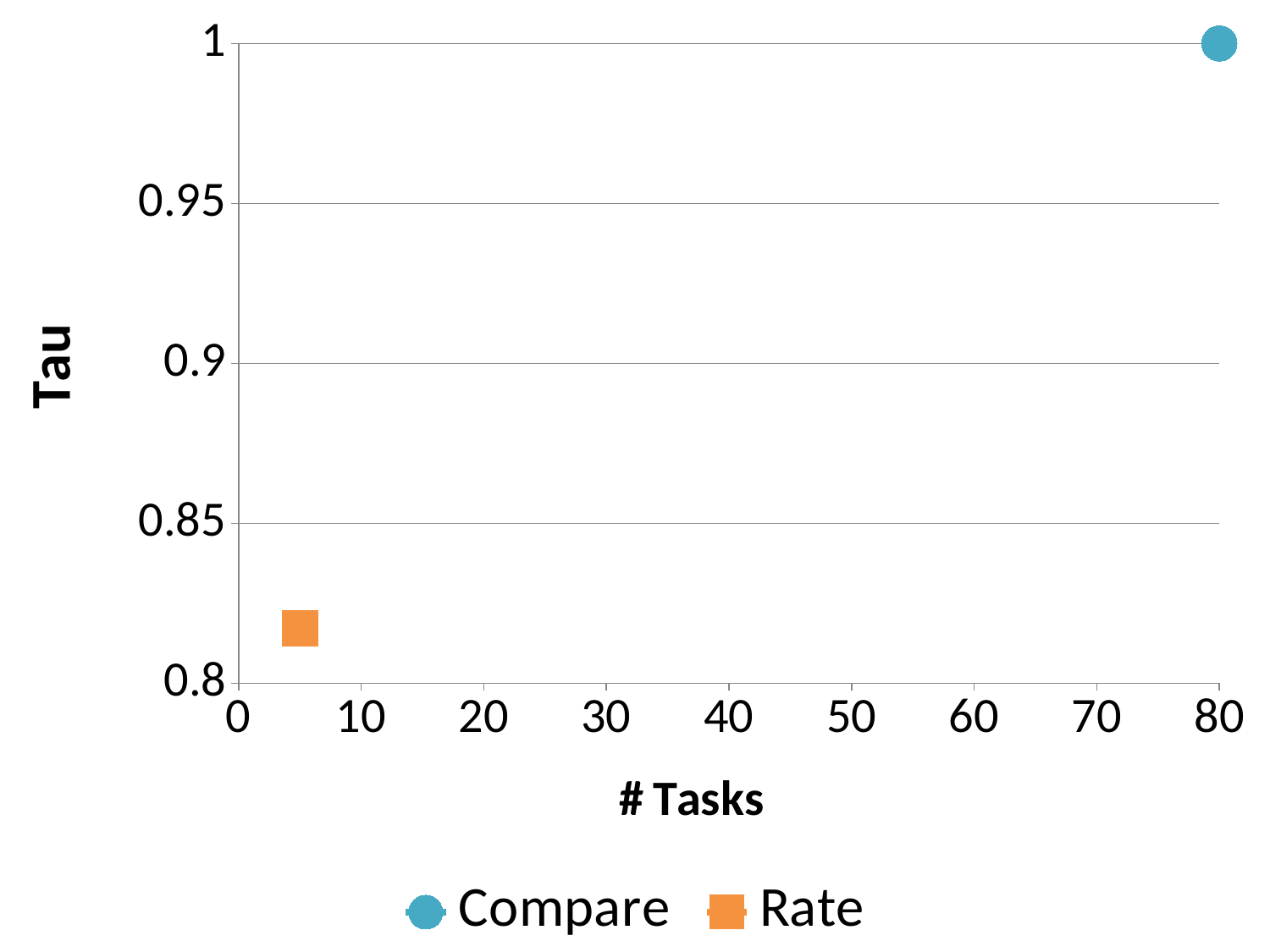
What are the two series named in the legend? Compare and Rate How many tasks does the Compare point correspond to on the x axis? 80 What kind of chart is shown on the slide? scatter chart What is the Tau value for the Compare point? 1 Which series has the higher Tau value, Compare or Rate? Compare Is the Tau value for the Rate point greater or less than 0.8? greater How many data points are plotted on the chart? 2 How many series does the legend list? 2 What is the label of the vertical axis? Tau Which series has the larger number of tasks, Compare or Rate? Compare Is the number of tasks for the Rate point greater or less than 10? less Is the Tau value for the Rate point greater or less than 0.85? less